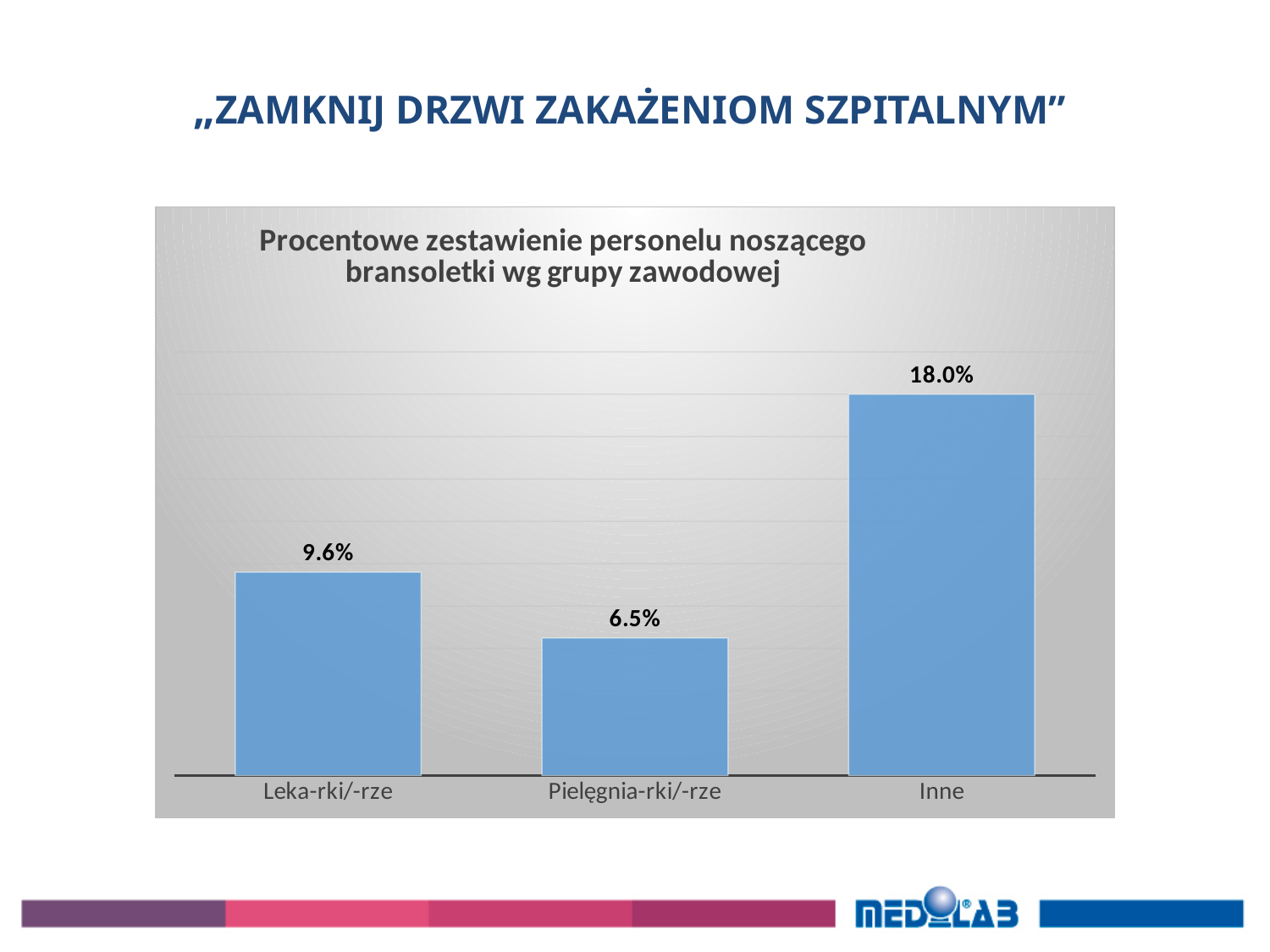
Which is larger, the value for Leka-rki/-rze or the value for Pielęgnia-rki/-rze? Leka-rki/-rze What is the value for Inne? 18.0% What is the value for Pielęgnia-rki/-rze? 6.5% Which category has the lowest value? Pielęgnia-rki/-rze What is the difference between the values for Inne and Leka-rki/-rze? 8.4% How many categories are shown in the chart? 3 What is the difference between the values for Leka-rki/-rze and Pielęgnia-rki/-rze? 3.1% What colour are the bars in the chart? Blue What kind of chart is shown on the slide? Bar chart Which category has the highest value? Inne What is the title of the chart? Procentowe zestawienie personelu noszącego bransoletki wg grupy zawodowej What is the value for Leka-rki/-rze? 9.6%